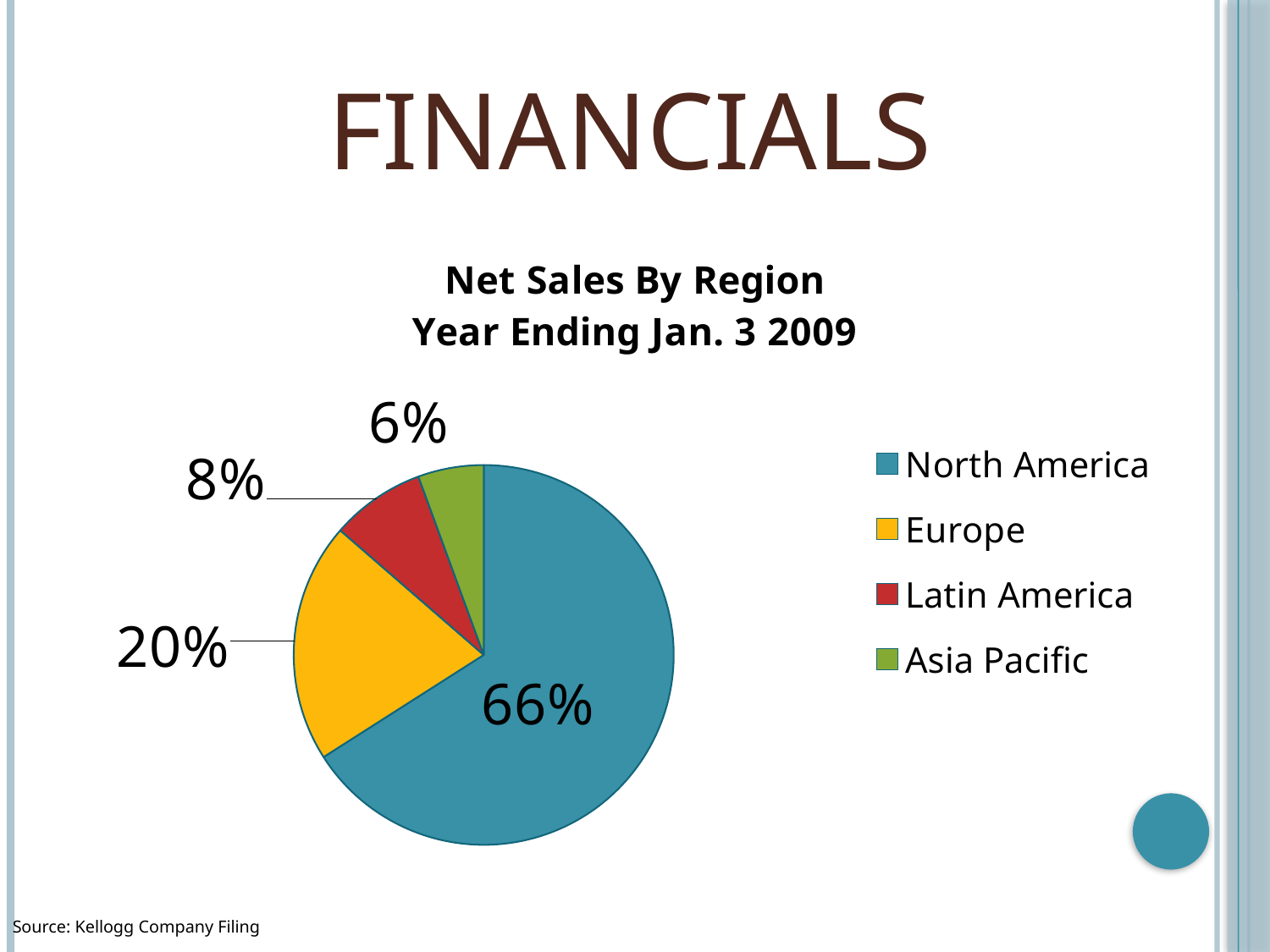
What is the difference in percentage points between North America's and Europe's shares of net sales? 46 What share of net sales does Latin America account for? 8% What is the difference in percentage points between Latin America's and Asia Pacific's shares of net sales? 2 What share of net sales does Asia Pacific account for? 6% Which region has the largest share of net sales? North America What is the title of the chart? Net Sales By Region Year Ending Jan. 3 2009 Which region has the smallest share of net sales? Asia Pacific What kind of chart is shown on the slide? Pie chart What share of net sales does Europe account for? 20% How many regions are shown in the pie chart? 4 What share of net sales does North America account for? 66% Which has a larger share of net sales, Europe or Latin America? Europe